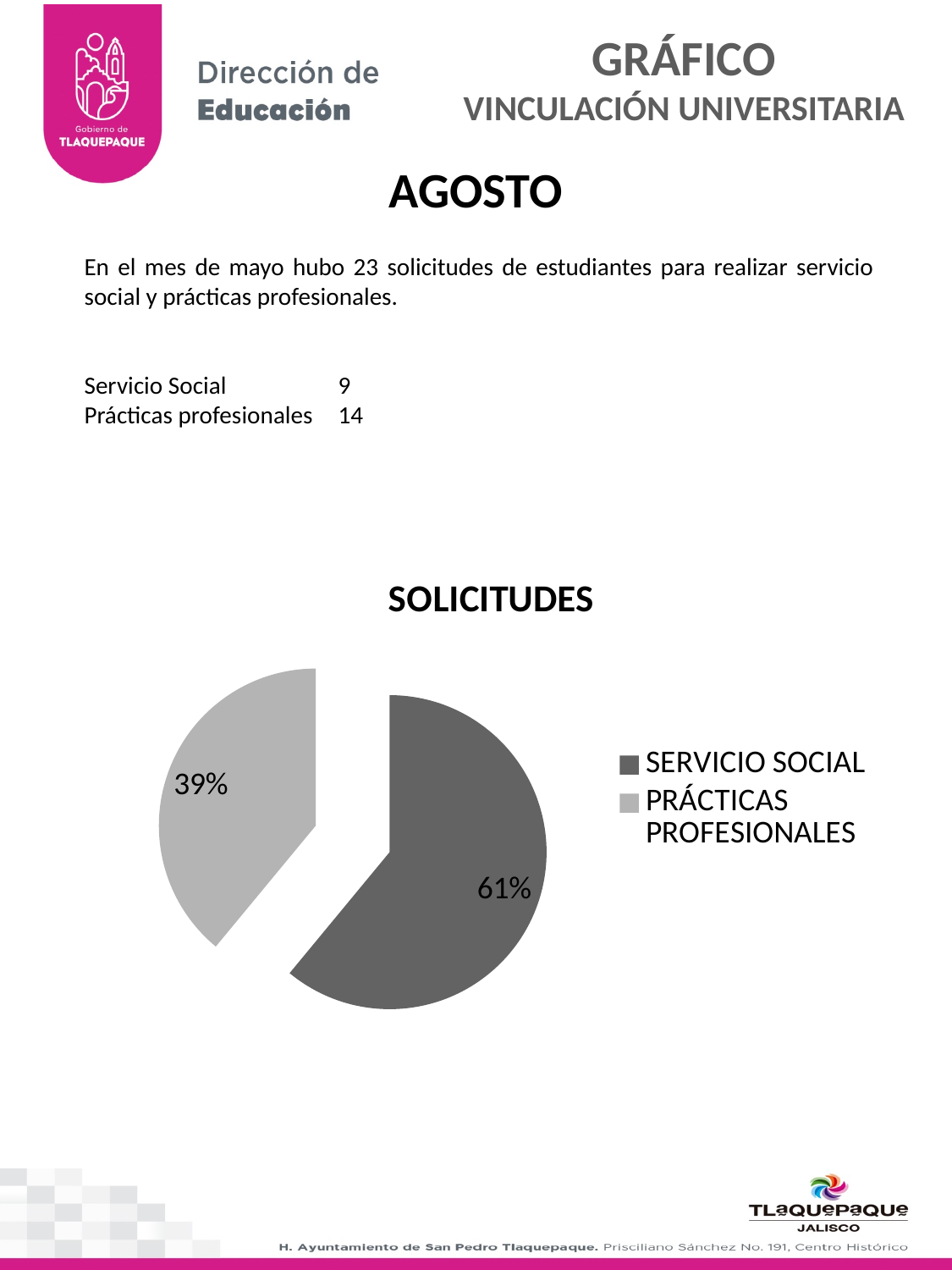
What is the difference in percentage points between the SERVICIO SOCIAL and PRÁCTICAS PROFESIONALES slices? 22 Which slice of the pie chart is the smallest? PRÁCTICAS PROFESIONALES How many entries does the legend of the pie chart list? 2 Which slice is larger in the pie chart, SERVICIO SOCIAL or PRÁCTICAS PROFESIONALES? SERVICIO SOCIAL What share of the pie does the SERVICIO SOCIAL slice represent? 61% What kind of chart is shown under the title SOLICITUDES? pie chart What percentage is shown for the PRÁCTICAS PROFESIONALES slice of the pie chart? 39% Which legend entry is shown in the lighter grey colour in the pie chart? PRÁCTICAS PROFESIONALES How many slices does the pie chart have? 2 What percentage is shown for the SERVICIO SOCIAL slice of the pie chart? 61% Which slice of the pie chart is the largest? SERVICIO SOCIAL What is the title of the chart on the slide? SOLICITUDES